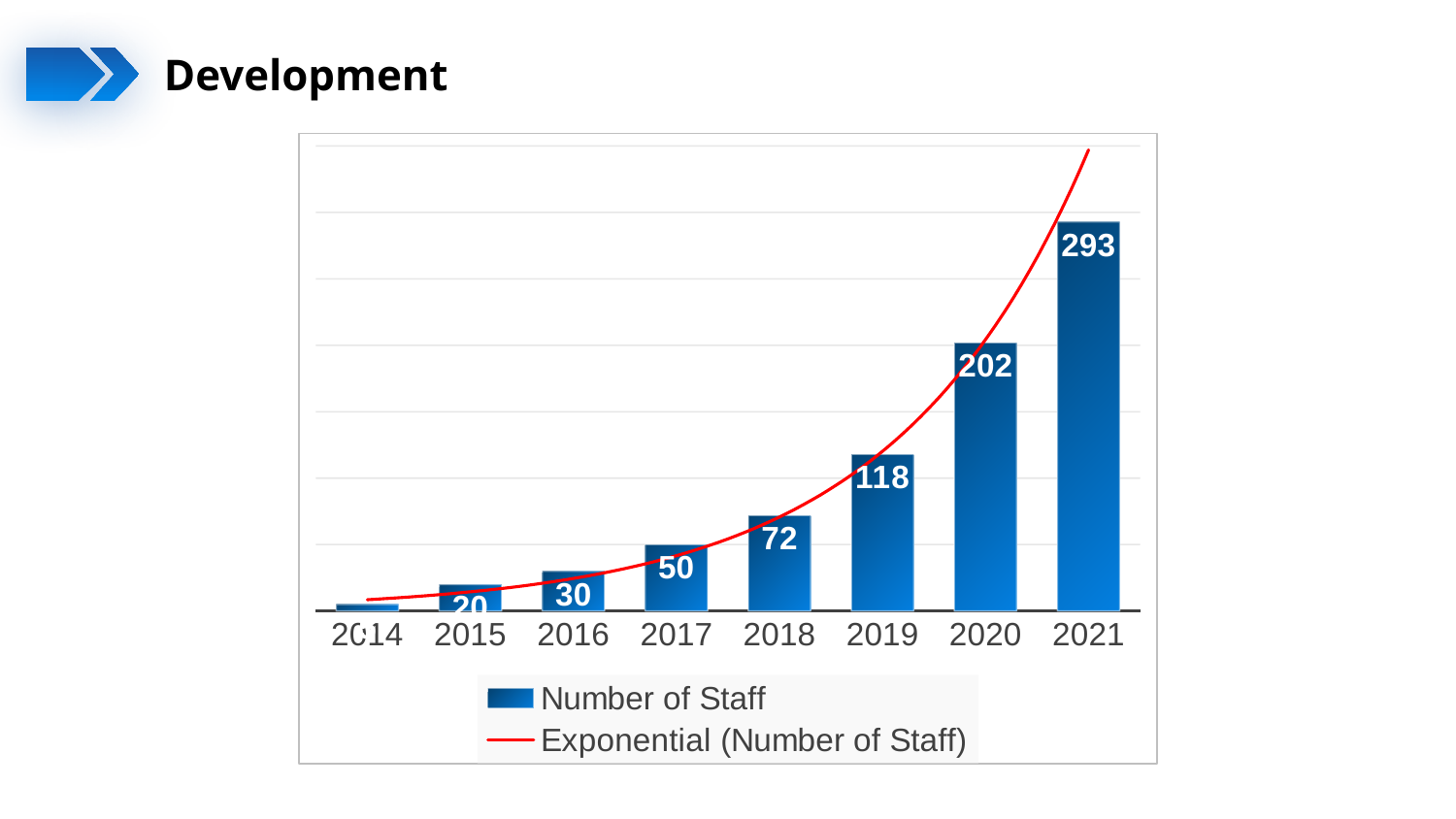
How many entries does the legend list? 2 Which year has a larger Number of Staff, 2017 or 2018? 2018 What is the Number of Staff in 2019? 118 How many years are shown on the x axis? 8 What is the difference in Number of Staff between 2019 and 2017? 68 What is the Number of Staff in 2016? 30 Which year has the lowest Number of Staff? 2014 Does the Number of Staff rise or fall from 2014 to 2021? rise What is the difference in Number of Staff between 2021 and 2020? 91 What is the Number of Staff in 2021? 293 What is the Number of Staff in 2018? 72 Which year has the highest Number of Staff? 2021